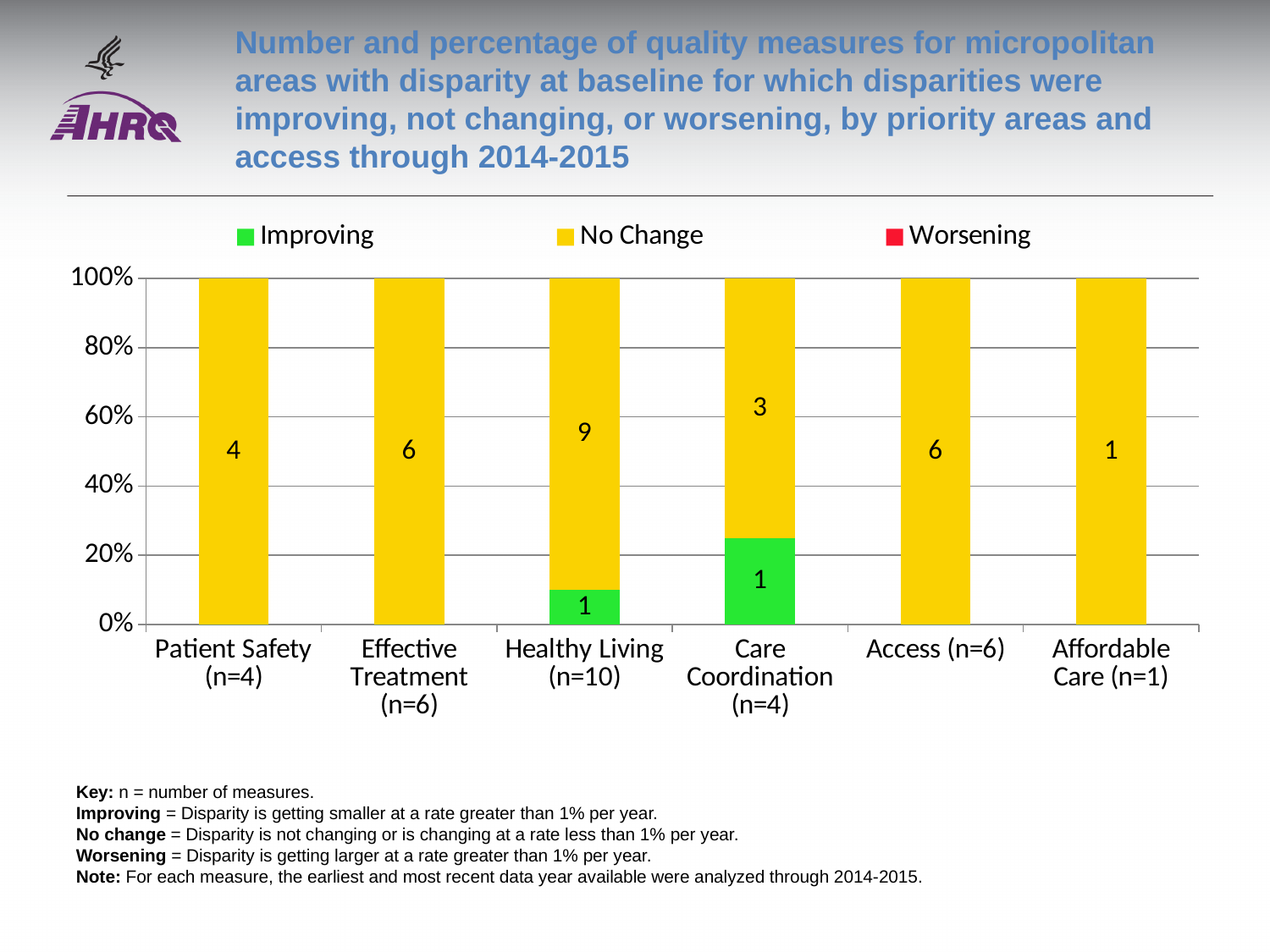
What is the No Change value for Healthy Living (n=10)? 9 What is the No Change value for Effective Treatment (n=6)? 6 What is the No Change value for Affordable Care (n=1)? 1 Which category has the highest No Change value? Healthy Living (n=10) How many series does the legend list? 3 Which is larger, the No Change value for Patient Safety (n=4) or for Access (n=6)? Access (n=6) Is the Improving share of the Care Coordination (n=4) bar greater or less than 20%? greater What kind of chart is shown on the slide? Stacked bar chart How many categories are shown on the x axis? 6 Which category has the lowest No Change value? Affordable Care (n=1) What is the difference between the No Change values for Healthy Living (n=10) and Care Coordination (n=4)? 6 What is the Improving value for Care Coordination (n=4)? 1